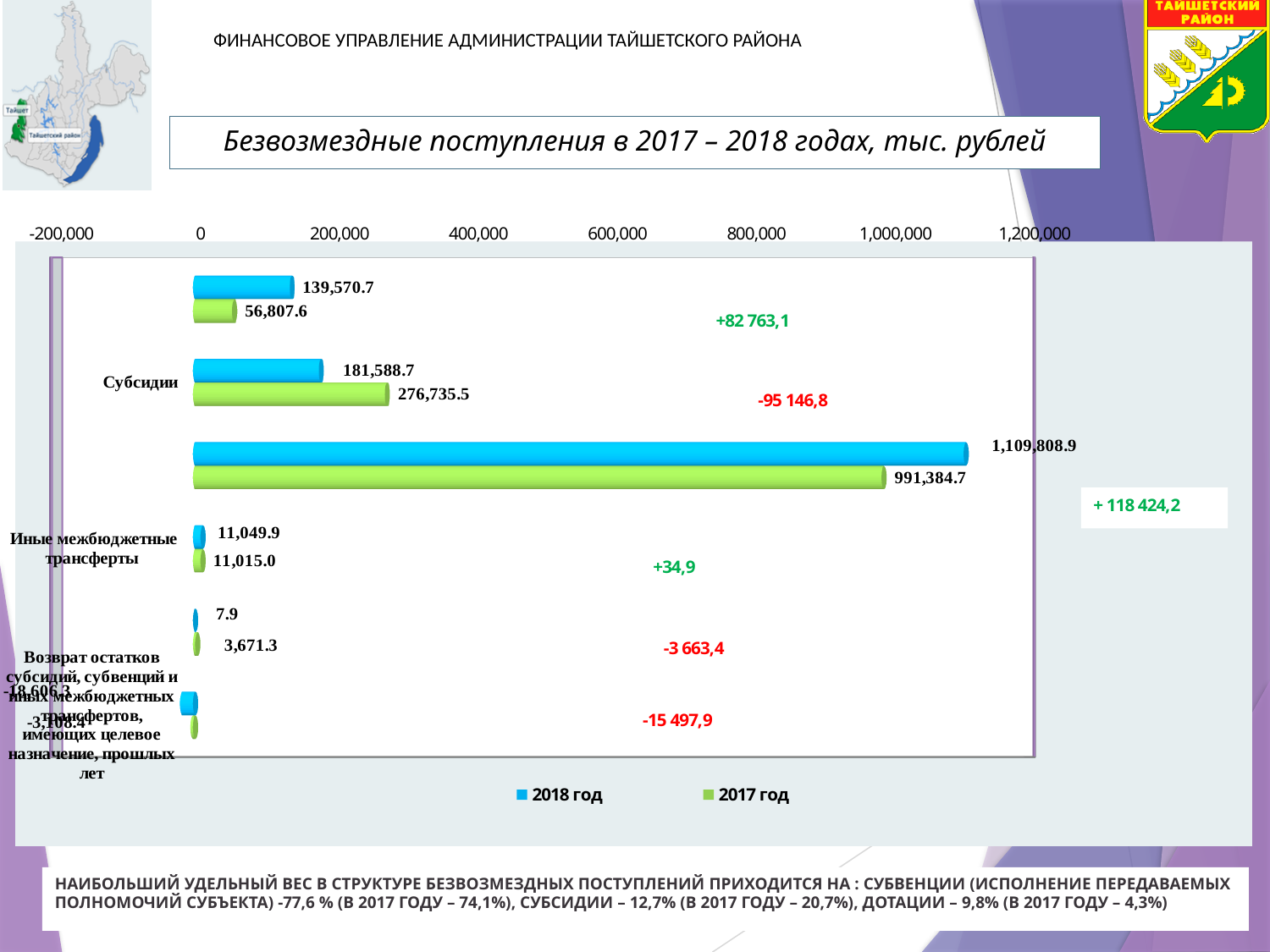
What is the value for Субсидии in the 2018 год series? 181,588.7 How many series does the chart legend list? 2 What kind of chart is shown on the slide? bar chart What is the value for Субсидии in the 2017 год series? 276,735.5 What is the difference between the 2017 год and 2018 год values for Субсидии? 95,146.8 What is the largest value labelled on the chart? 1,109,808.9 What are the two series named in the chart legend? 2018 год and 2017 год Is the 2018 год value for Субсидии greater or less than 200,000? less What is the value for Иные межбюджетные трансферты in the 2018 год series? 11,049.9 What is the value for Иные межбюджетные трансферты in the 2017 год series? 11,015.0 For Субсидии, which series has the larger value, 2018 год or 2017 год? 2017 год What is the title of the chart on the slide? Безвозмездные поступления в 2017 – 2018 годах, тыс. рублей